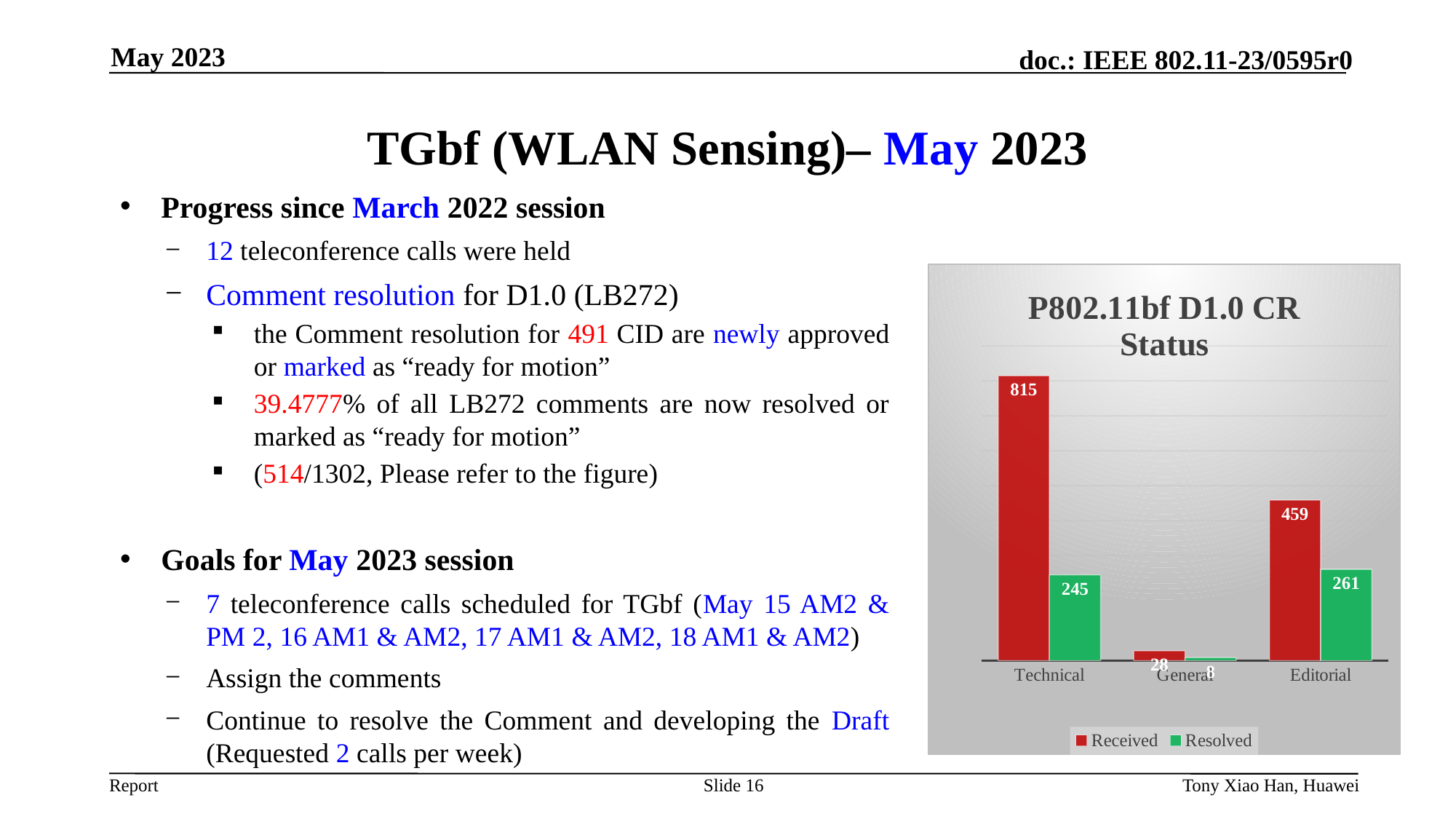
What is the Resolved value for the Editorial category? 261 What is the Received value for the General category? 28 What is the difference between Received and Resolved for the Editorial category? 198 How many series does the legend list? 2 What is the Received value for the Technical category? 815 What is the Resolved value for the Technical category? 245 Which category has the highest Received value? Technical What is the title of the chart? P802.11bf D1.0 CR Status Which is larger, the Resolved value for Editorial or the Resolved value for Technical? Editorial How many categories are shown on the x axis? 3 Which category has the lowest Resolved value? General What is the difference between Received and Resolved for the Technical category? 570